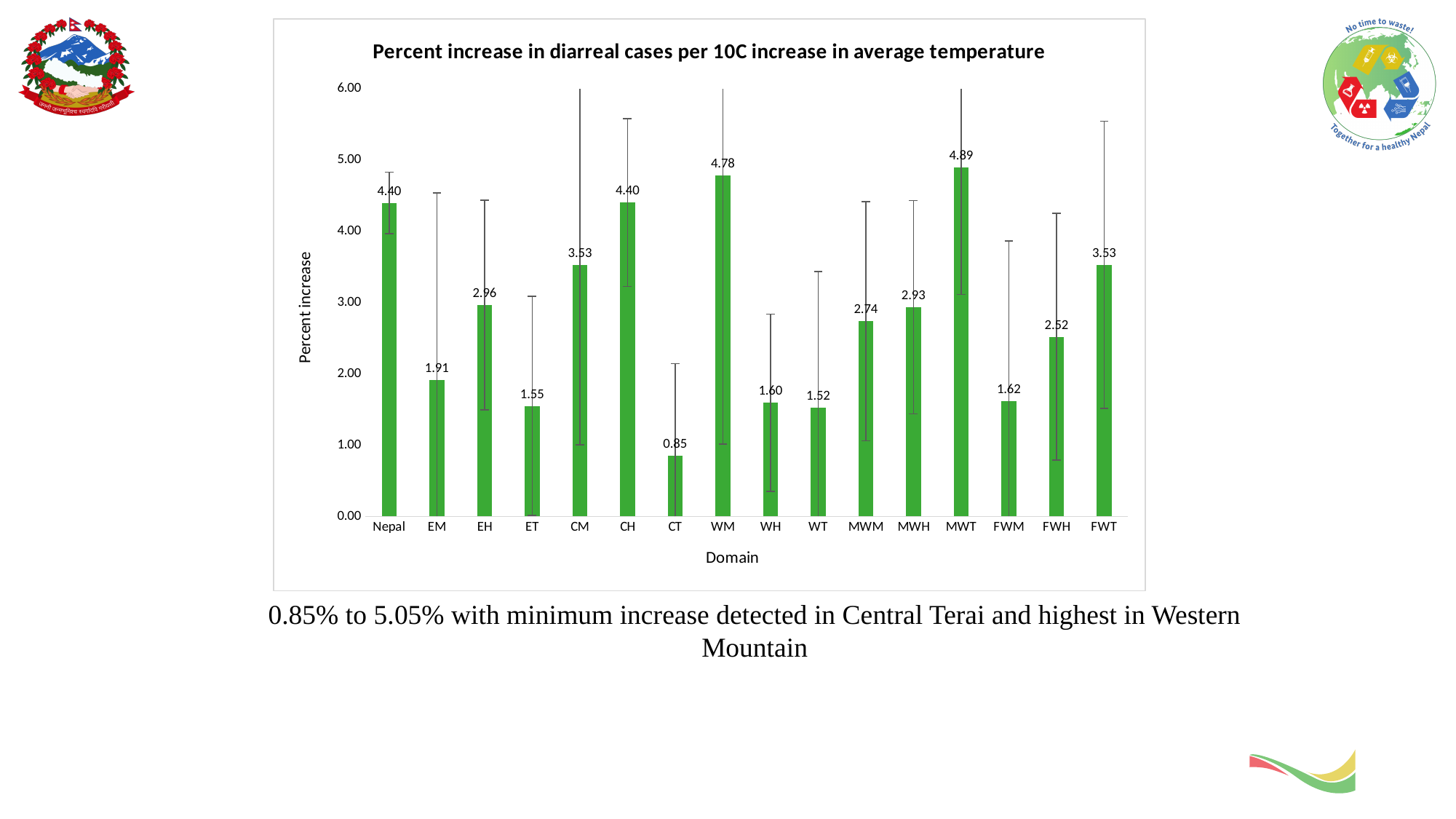
Which domain has the lowest percent increase? CT What is the percent increase value for WM? 4.78 What is the title of the chart? Percent increase in diarreal cases per 10C increase in average temperature What is the difference between the values for MWT and CT? 4.04 What is the label of the x axis? Domain What kind of chart is shown on the slide? Bar chart What is the percent increase value for CT? 0.85 What is the percent increase value for MWH? 2.93 How many domains are shown on the x axis? 16 Which has a larger value, EH or FWH? EH What is the percent increase value for Nepal? 4.40 Which domain has the highest percent increase? MWT